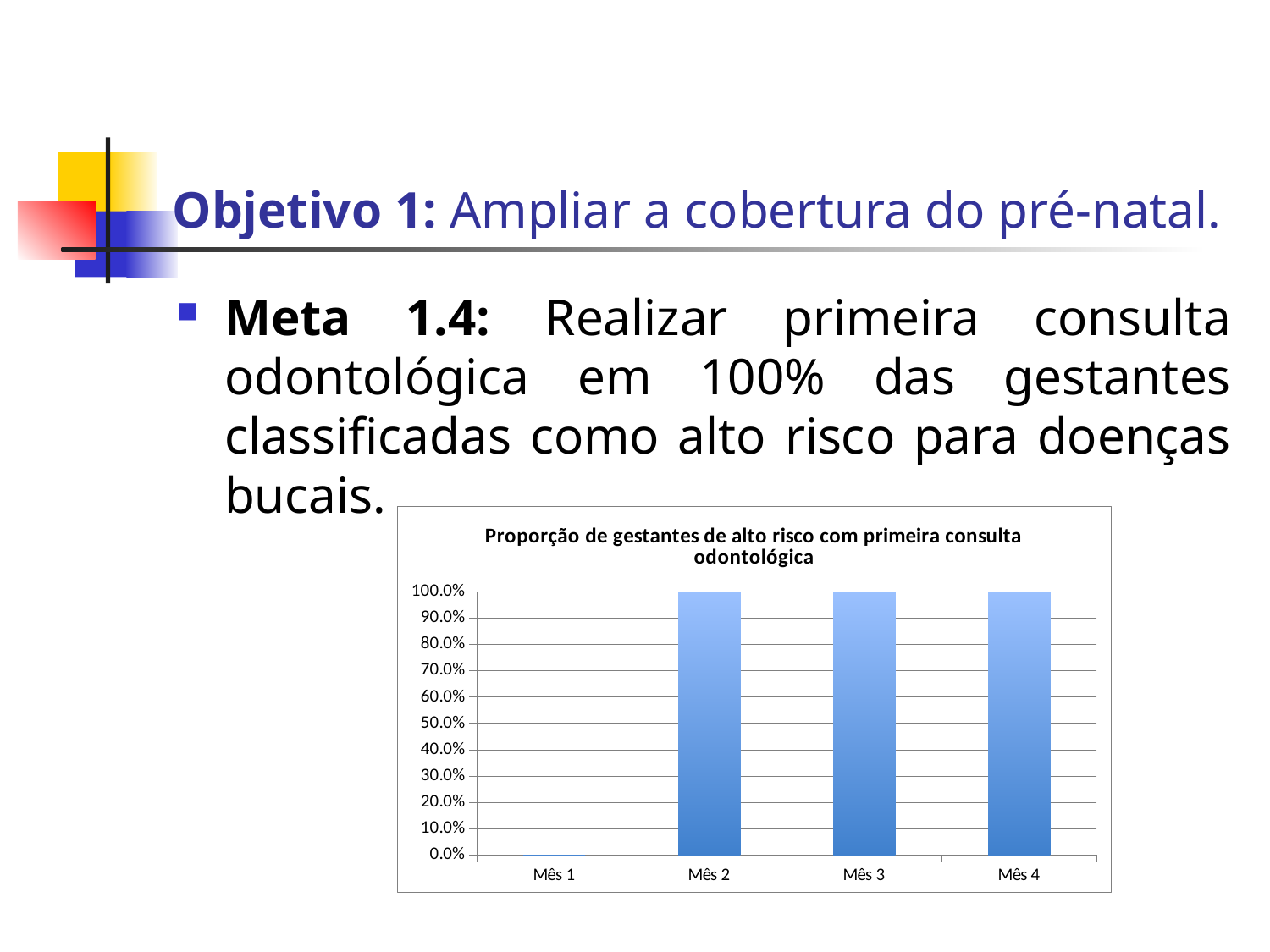
Is the value for Mês 3 greater or less than 50.0%? greater What is the title of the chart? Proporção de gestantes de alto risco com primeira consulta odontológica Does the value rise or fall from Mês 1 to Mês 2? rise What is the value for Mês 1 in the chart? 0.0% What is the value for Mês 4 in the chart? 100.0% How many months reach 100.0% in the chart? 3 How many months (categories) are shown on the x axis of the chart? 4 What is the value for Mês 2 in the chart? 100.0% What is the difference between the value for Mês 2 and the value for Mês 1? 100.0% Which month has the lowest value in the chart? Mês 1 What kind of chart is shown on the slide? bar chart Which is larger, the value for Mês 1 or the value for Mês 3? Mês 3